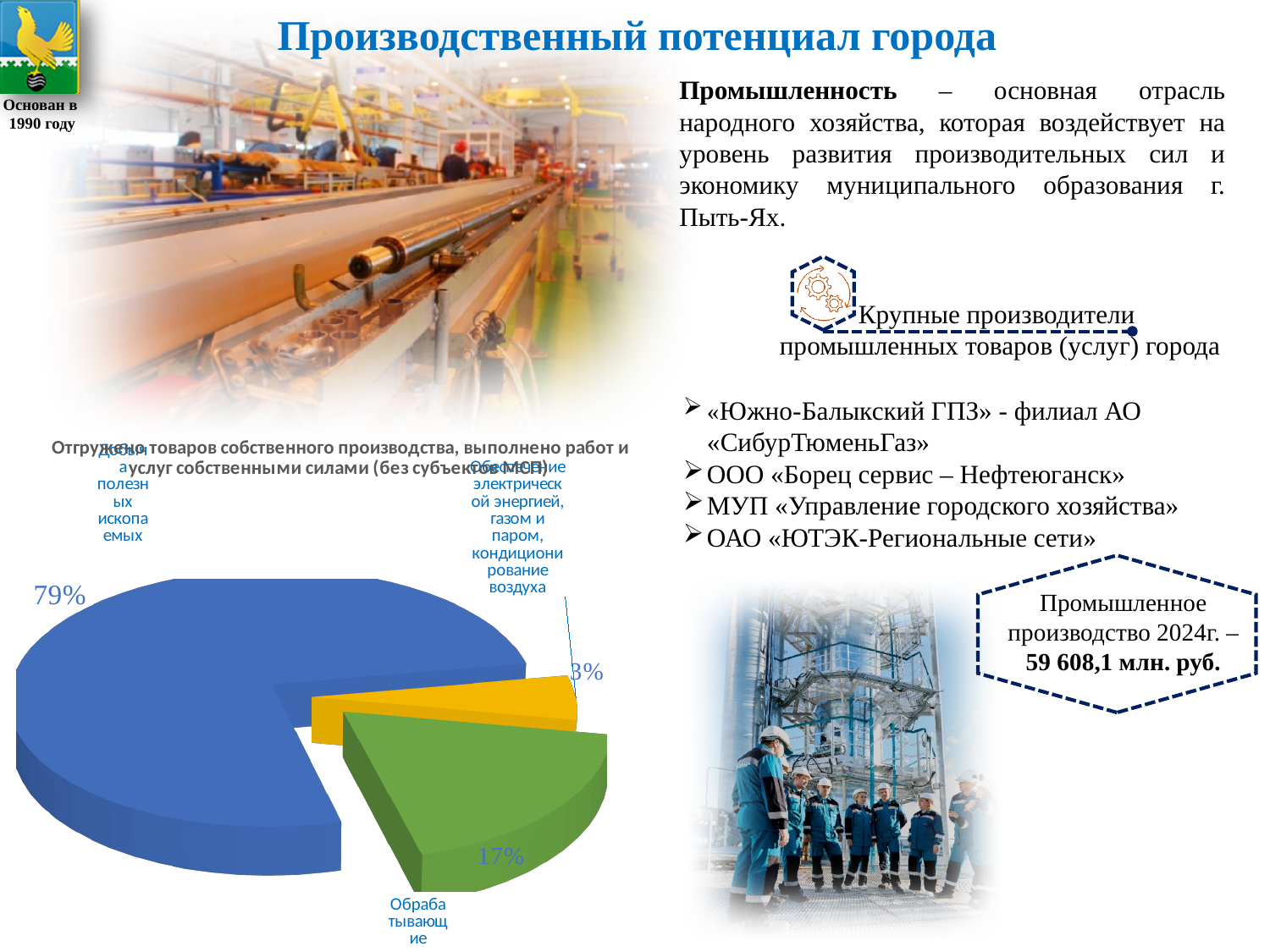
Which category has the largest share of the pie? Добыча полезных ископаемых What share of the pie does «Обеспечение электрической энергией, газом и паром, кондиционирование воздуха» have? 3% What kind of chart is shown on the slide? Pie chart What colour is the «Обрабатывающие» slice? Green What share of the pie does «Добыча полезных ископаемых» have? 79% What share of the pie does «Обрабатывающие» have? 17% What is the difference in percentage points between the «Добыча полезных ископаемых» slice and the «Обрабатывающие» slice? 62 Which is larger: the share for «Обрабатывающие» or the share for «Обеспечение электрической энергией, газом и паром, кондиционирование воздуха»? Обрабатывающие How many slices does the pie chart have? 3 What colour is the «Добыча полезных ископаемых» slice? Blue Which category has the smallest share of the pie? Обеспечение электрической энергией, газом и паром, кондиционирование воздуха